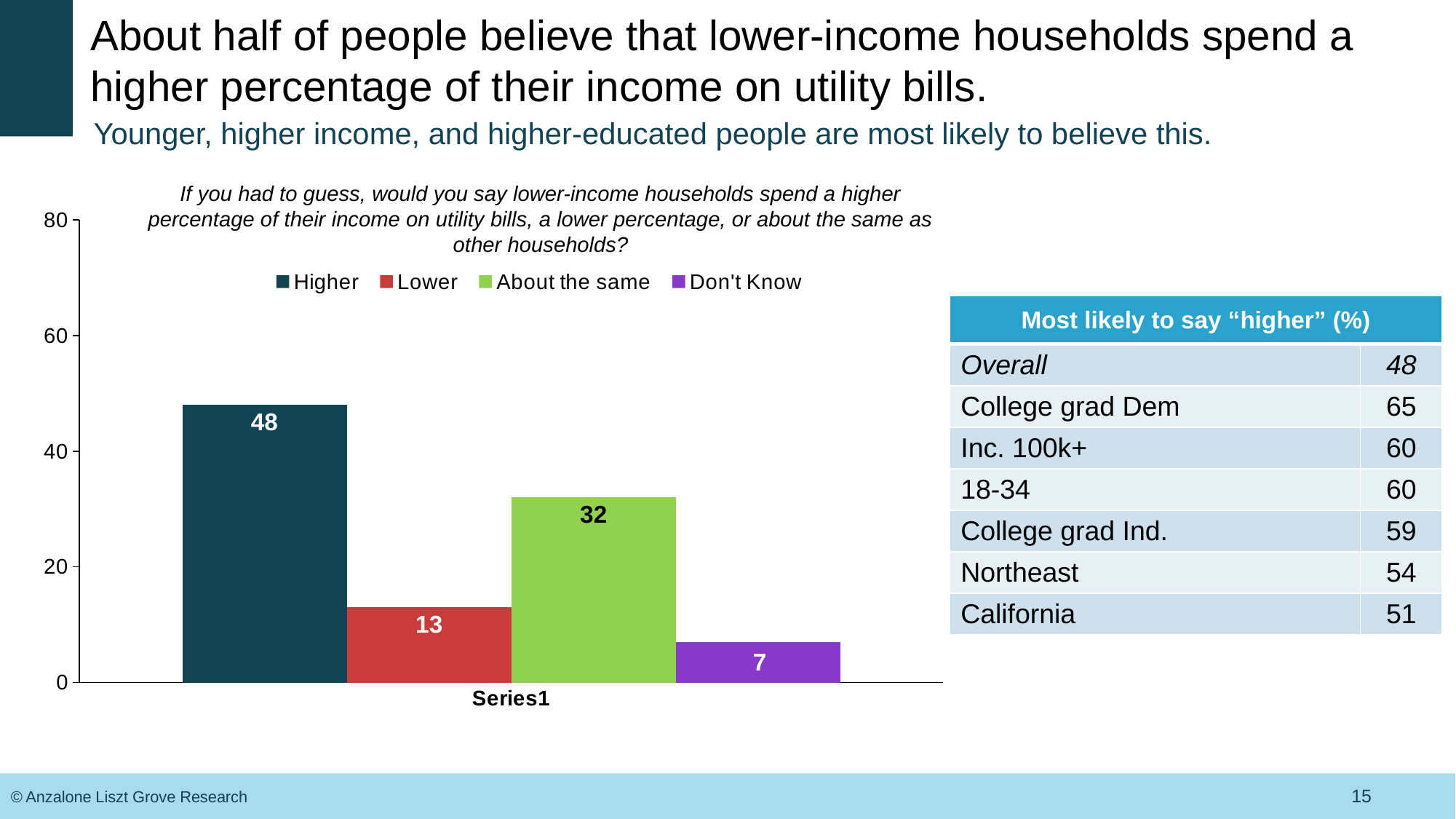
Is the value for "Higher" greater or less than 40? greater Which response has the lowest value in the chart? Don't Know Which response has the highest value in the chart? Higher What is the value for "Lower" in the chart? 13 What is the value for "Higher" in the chart? 48 What is the value for "About the same" in the chart? 32 What is the difference between the values for "Higher" and "About the same"? 16 What is the value for "Don't Know" in the chart? 7 How many series does the chart legend list? 4 What colour is the bar for "Don't Know"? Purple Which is larger, the value for "Lower" or the value for "About the same"? About the same What kind of chart is shown on the slide? Bar chart